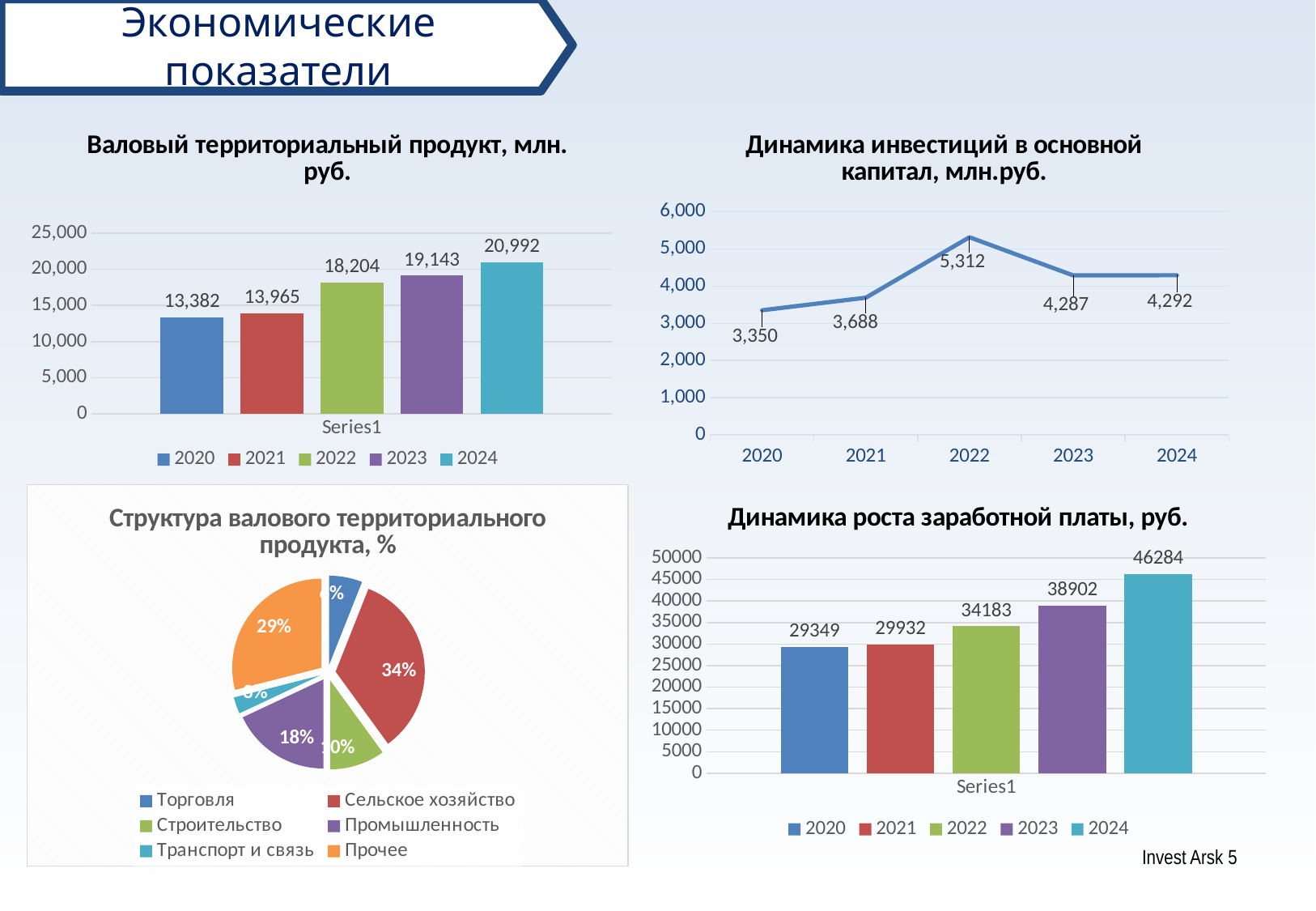
In the chart 'Валовый территориальный продукт, млн. руб.', which year has the highest value? 2024 What kind of chart is 'Динамика инвестиций в основной капитал, млн.руб.'? line chart In the chart 'Динамика роста заработной платы, руб.', what is the value for 2023? 38902 In the chart 'Динамика инвестиций в основной капитал, млн.руб.', how many data points are plotted? 5 In the pie chart 'Структура валового территориального продукта, %', what share does 'Сельское хозяйство' have? 34% In the chart 'Динамика инвестиций в основной капитал, млн.руб.', what is the value for 2022? 5,312 In the chart 'Динамика инвестиций в основной капитал, млн.руб.', which year has the lowest value? 2020 In the chart 'Валовый территориальный продукт, млн. руб.', what is the value for 2022? 18,204 In the chart 'Динамика роста заработной платы, руб.', do the values rise or fall from 2020 to 2024? rise How many entries does the legend of the chart 'Динамика роста заработной платы, руб.' list? 5 In the pie chart 'Структура валового территориального продукта, %', which is larger: 'Промышленность' or 'Прочее'? Прочее In the chart 'Валовый территориальный продукт, млн. руб.', what is the difference between the 2024 and 2020 values? 7,610